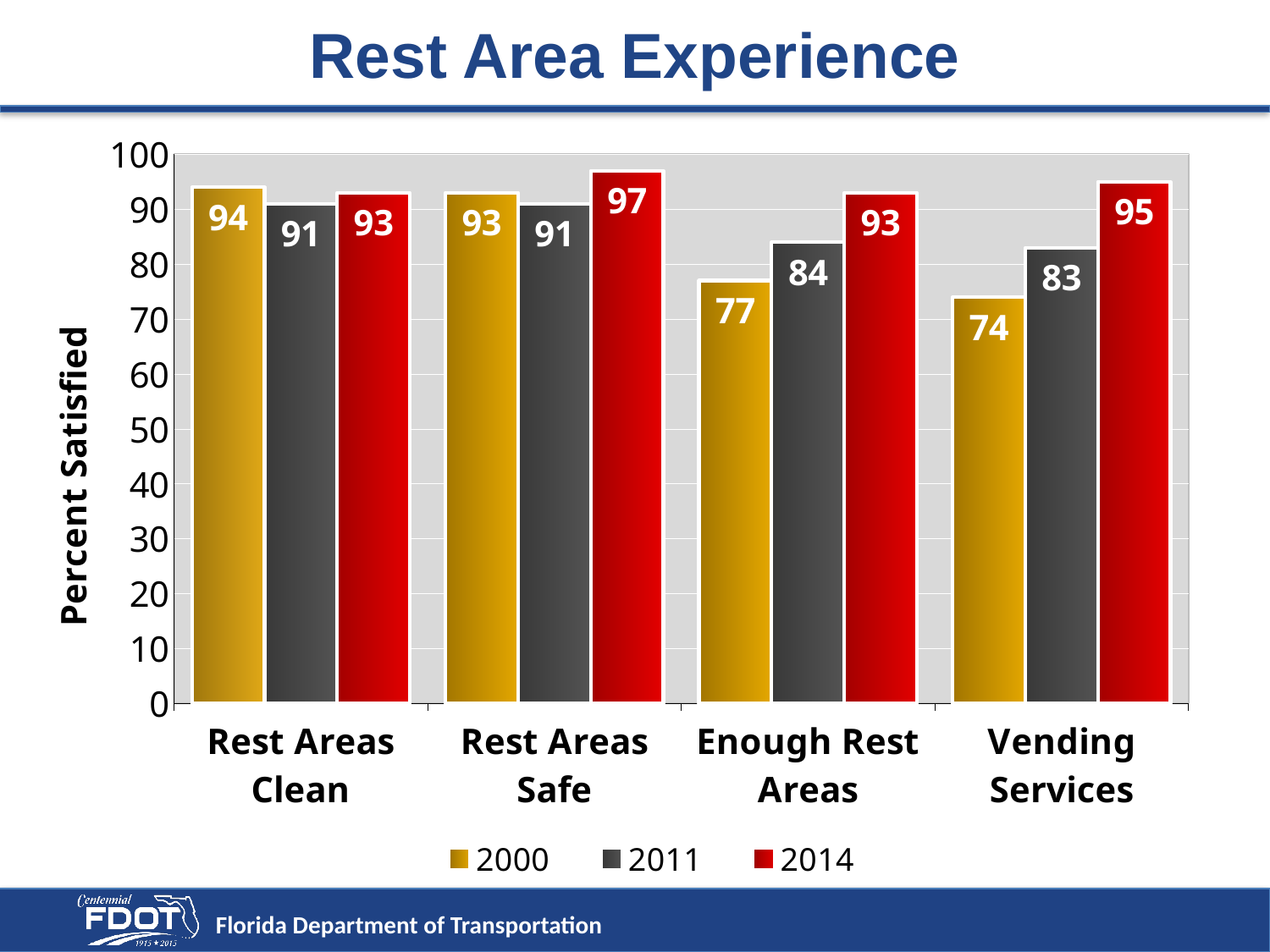
What is the difference between the 2014 and 2000 values for Vending Services? 21 What kind of chart is shown on the slide? Bar chart How many series does the legend list? 3 Which category has the lowest 2000 value? Vending Services What is the label of the y axis? Percent Satisfied Which is larger for Rest Areas Clean, the 2000 value or the 2011 value? 2000 What is the 2011 value for Enough Rest Areas? 84 What is the difference between the 2014 and 2011 values for Enough Rest Areas? 9 How many categories are shown on the x axis? 4 What is the 2000 value for Vending Services? 74 Which category has the highest 2014 value? Rest Areas Safe What is the 2014 value for Rest Areas Safe? 97